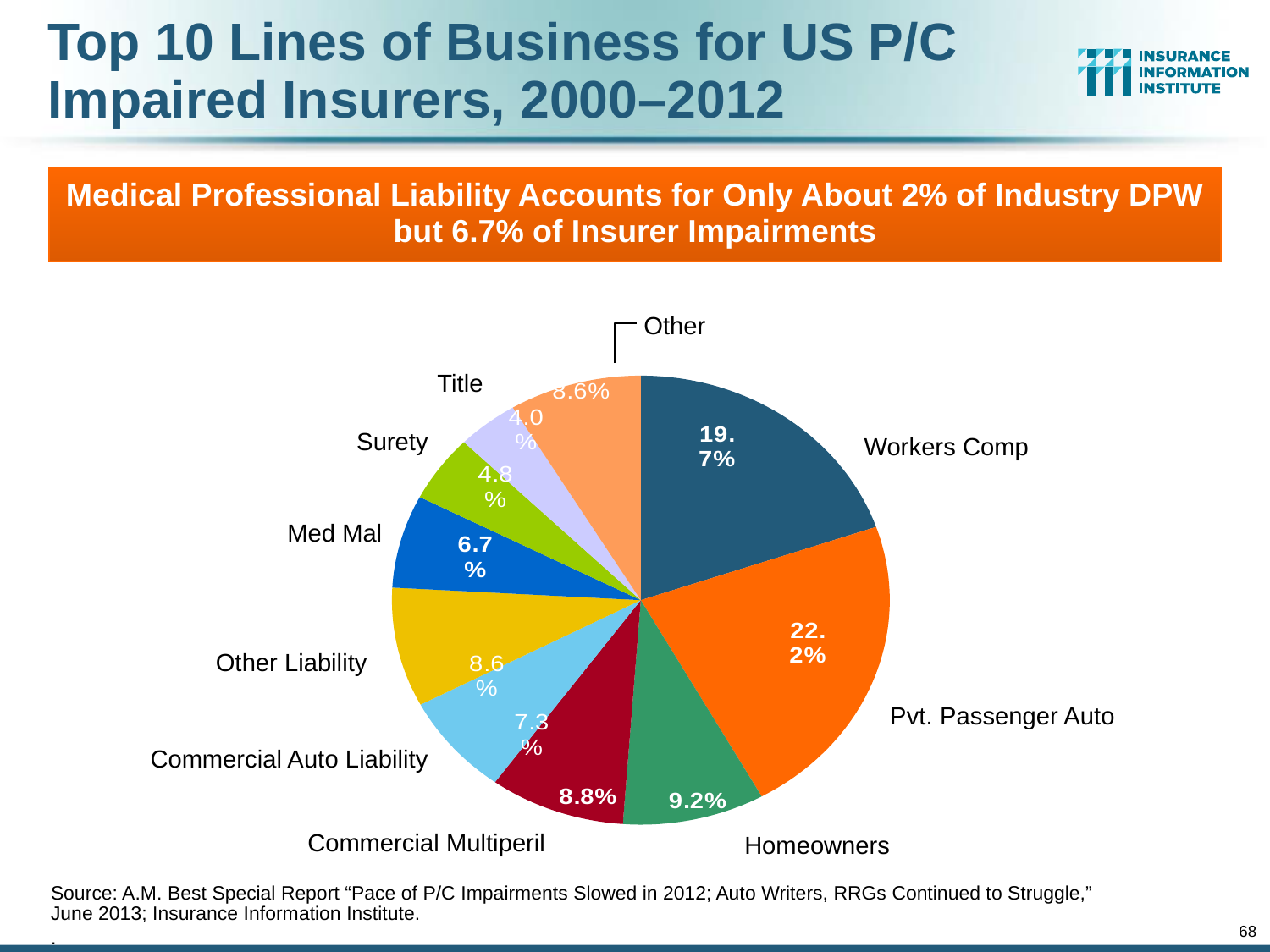
How many slices does the pie chart have? 10 What percentage is shown for Med Mal? 6.7% What is the title of the slide containing the chart? Top 10 Lines of Business for US P/C Impaired Insurers, 2000–2012 What share of impairments does Pvt. Passenger Auto account for? 22.2% What is the difference between the Surety and Title shares? 0.8% Which line of business has the smallest slice of the pie? Title What kind of chart is shown on the slide? Pie chart What is the difference between the Pvt. Passenger Auto and Workers Comp shares? 2.5% What is the value for Homeowners? 9.2% What is the value shown for Workers Comp? 19.7% Which line of business has the largest slice of the pie? Pvt. Passenger Auto Which is larger, the share for Commercial Multiperil or the share for Commercial Auto Liability? Commercial Multiperil